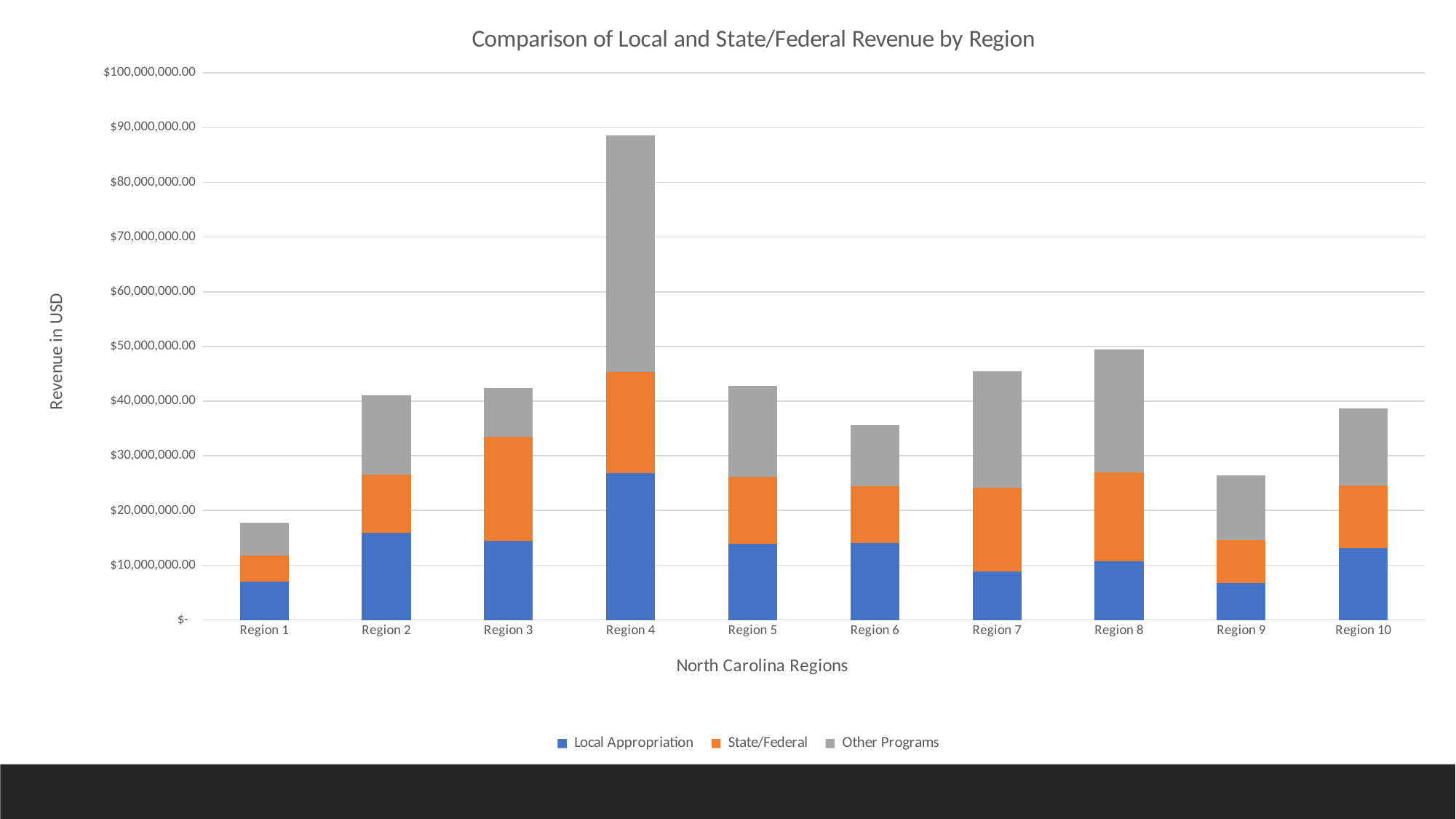
Which has the larger total revenue, Region 4 or Region 8? Region 4 How many regions are shown on the x axis? 10 Is the total revenue for Region 1 greater or less than $20,000,000.00? less Which region has the highest total revenue? Region 4 How many series does the legend list? 3 Which region has the largest Local Appropriation segment? Region 4 What is the title of the chart? Comparison of Local and State/Federal Revenue by Region What is the label of the y axis? Revenue in USD Is the total revenue for Region 9 greater or less than $30,000,000.00? less What kind of chart is shown on the slide? Stacked bar chart Is the total revenue for Region 4 greater or less than $80,000,000.00? greater Which region has the lowest total revenue? Region 1